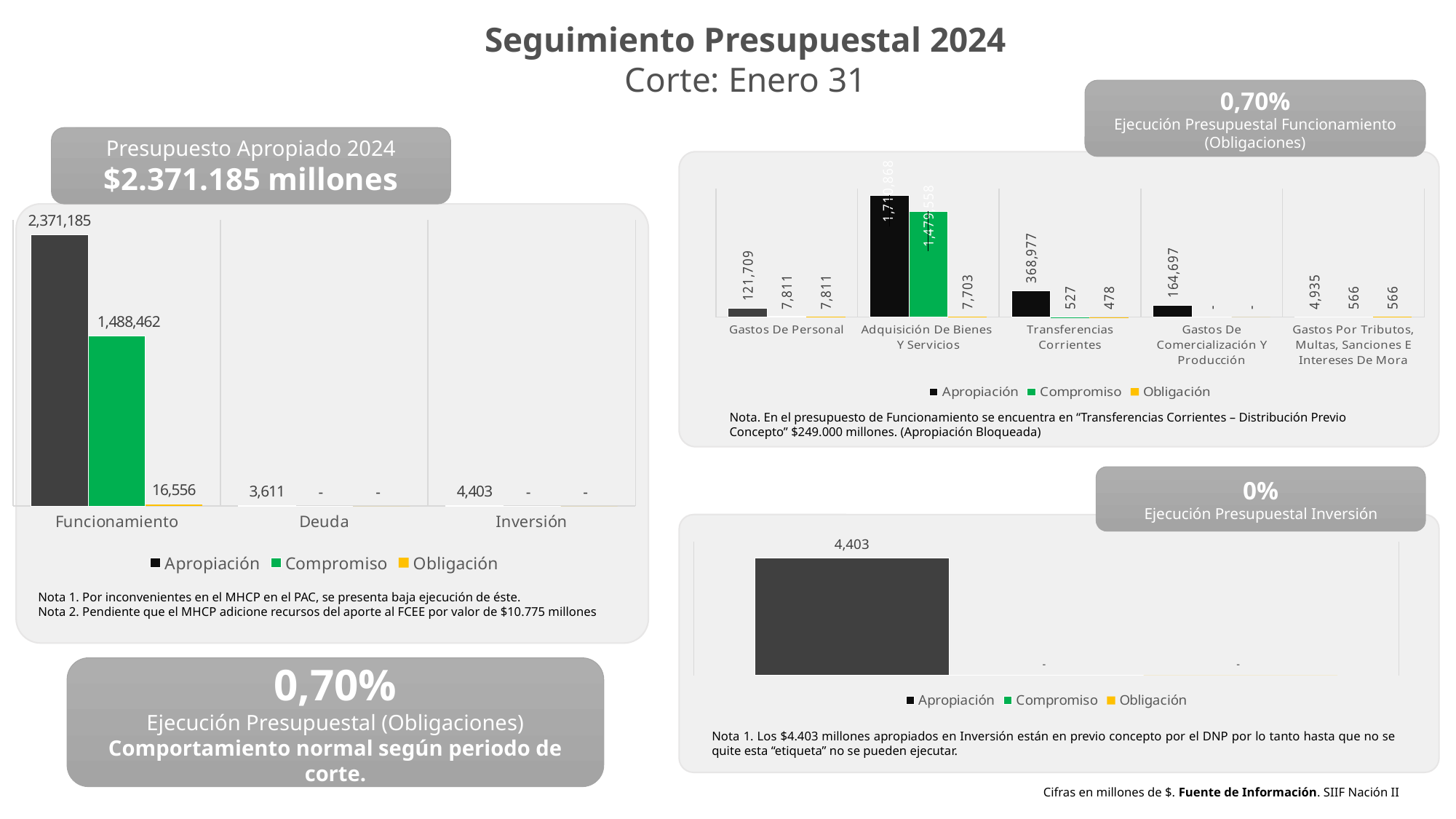
In the bottom-right chart, what is the Apropiación value shown? 4,403 In the top-right chart, what is the Apropiación value for Transferencias Corrientes? 368,977 In the left chart, what is the Apropiación value for Funcionamiento? 2,371,185 In the left chart, what is the difference between the Apropiación and Compromiso values for Funcionamiento? 882,723 In the left chart, how many series does the legend list? 3 In the left chart, which category has the highest Apropiación value? Funcionamiento In the top-right chart, what is the Apropiación value for Gastos De Personal? 121,709 In the left chart, what is the Apropiación value for Deuda? 3,611 In the left chart, what is the Compromiso value for Funcionamiento? 1,488,462 In the top-right chart, what is the Obligación value for Transferencias Corrientes? 478 In the top-right chart, which category has the highest Apropiación value? Adquisición De Bienes Y Servicios In the left chart, what is the Obligación value for Funcionamiento? 16,556